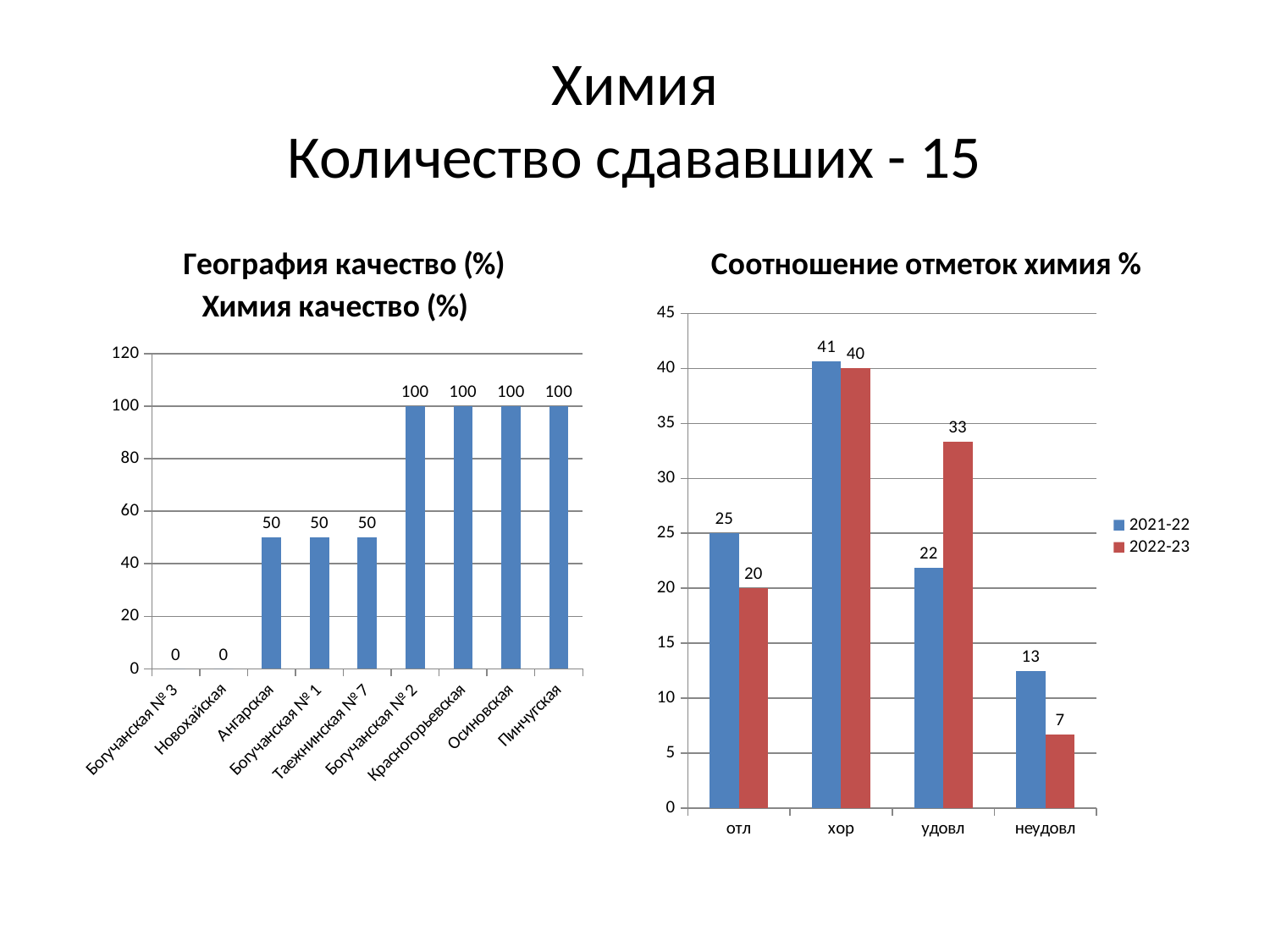
In the left chart (Химия качество (%)), what is the value for Ангарская? 50 In the right chart (Соотношение отметок химия %), how many series does the legend list? 2 In the right chart (Соотношение отметок химия %), what is the value for неудовл in 2021-22? 13 In the right chart (Соотношение отметок химия %), what is the difference between the 2022-23 and 2021-22 values for удовл? 11 What type of chart is the right chart (Соотношение отметок химия %)? Bar chart In the right chart (Соотношение отметок химия %), which category has the highest value for 2021-22? хор In the left chart (Химия качество (%)), what is the value for Богучанская № 3? 0 In the right chart (Соотношение отметок химия %), which category has the lowest value for 2022-23? неудовл In the left chart (Химия качество (%)), which is larger, the value for Богучанская № 2 or the value for Богучанская № 1? Богучанская № 2 In the left chart (Химия качество (%)), how many schools (categories) are shown on the x axis? 9 In the left chart (Химия качество (%)), what is the difference between the values for Пинчугская and Таежнинская № 7? 50 In the right chart (Соотношение отметок химия %), what is the value for удовл in 2022-23? 33